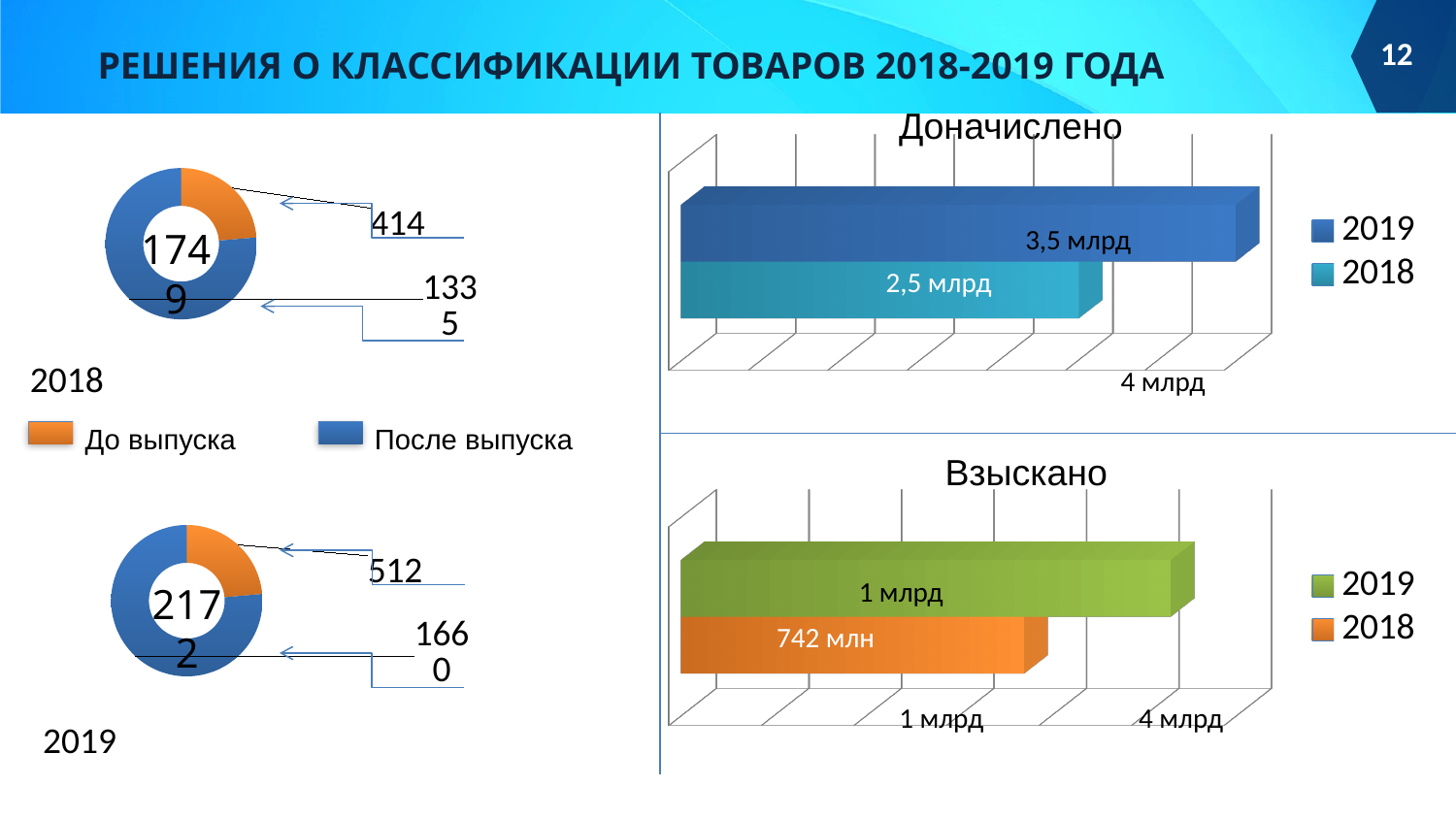
In the 'Взыскано' chart, is the value for 2019 larger or smaller than the value for 2018? larger In the 'Доначислено' chart, what is the value for 2018? 2,5 млрд In the 2019 donut chart on the left, what is the value for 'До выпуска'? 512 How many series does the legend of the 'Доначислено' chart list? 2 What kind of chart is the 'Взыскано' chart? bar chart In the 'Доначислено' chart, what is the difference between the 2019 and 2018 values? 1 млрд In the 'Взыскано' chart, which year has the lower value? 2018 In the 'Доначислено' chart, which year has the higher value? 2019 In the 'Взыскано' chart, what is the value for 2019? 1 млрд In the 'Доначислено' chart, what is the value for 2019? 3,5 млрд In the 'Взыскано' chart, what is the value for 2018? 742 млн In the 2018 donut chart on the left, what is the value for 'До выпуска'? 414